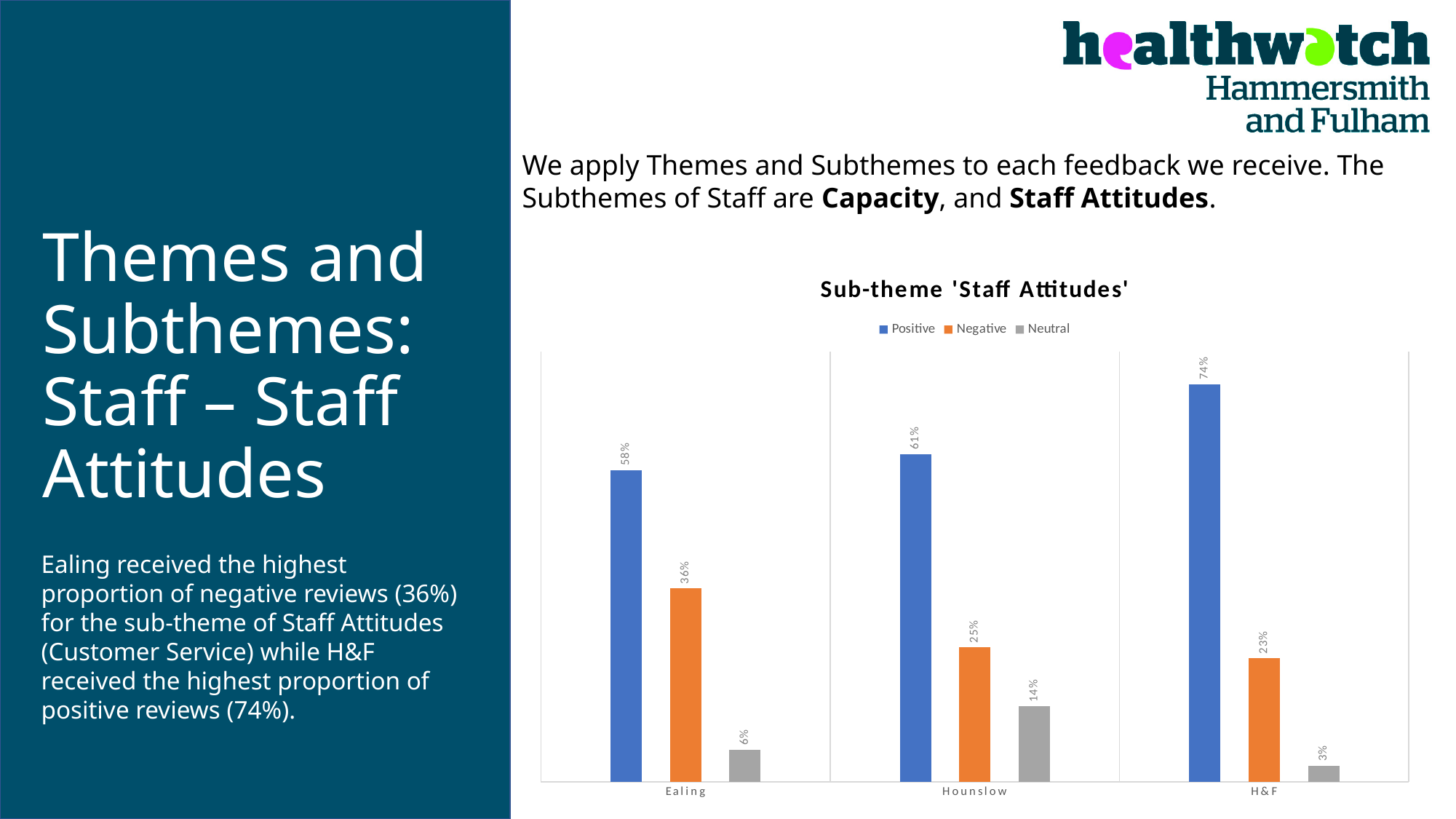
Which category has the highest Positive value? H&F What is the Neutral value for H&F? 3% What is the Negative value for Hounslow? 25% Which is larger, the Neutral value for Hounslow or the Neutral value for Ealing? Hounslow Do the Positive values rise or fall from Ealing to H&F? Rise Which category has the lowest Neutral value? H&F How many series does the legend list? 3 How many categories are shown on the x axis? 3 What is the title of the chart? Sub-theme 'Staff Attitudes' What is the Positive value for Ealing? 58% What is the difference between the Negative values for Ealing and H&F? 13% What kind of chart is shown? Bar chart